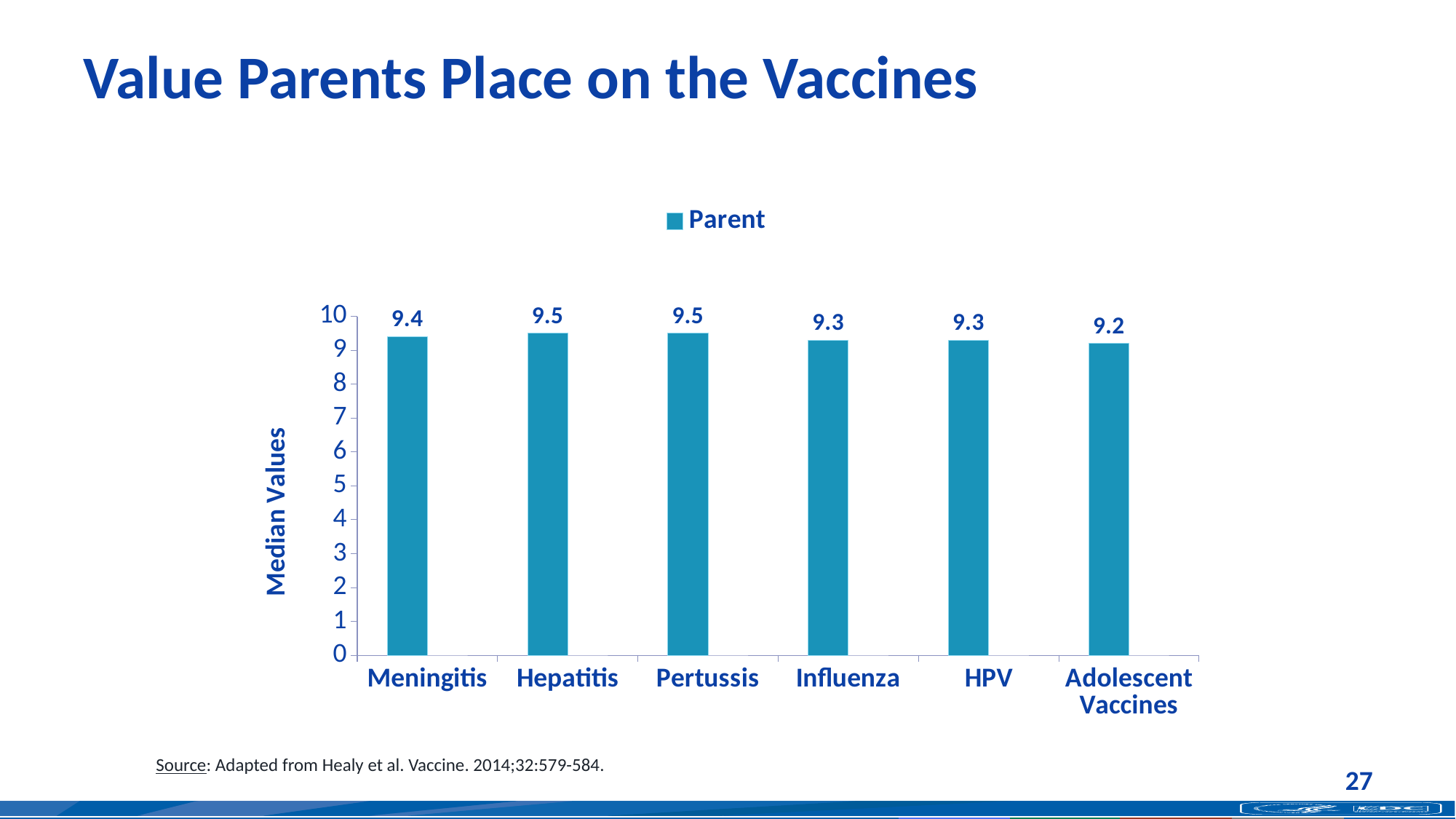
What is the label of the y axis? Median Values What is the median value for Influenza? 9.3 How many series does the legend list? 1 What is the median value for Pertussis? 9.5 Which vaccine has the lowest median value? Adolescent Vaccines What kind of chart is shown on the slide? Bar chart What is the difference between the median values for Meningitis and HPV? 0.1 What is the median value for Adolescent Vaccines? 9.2 What is the median value for Meningitis? 9.4 Which has a higher median value, Pertussis or Influenza? Pertussis What is the difference between the median values for Hepatitis and Adolescent Vaccines? 0.3 How many vaccine categories are shown on the x axis? 6